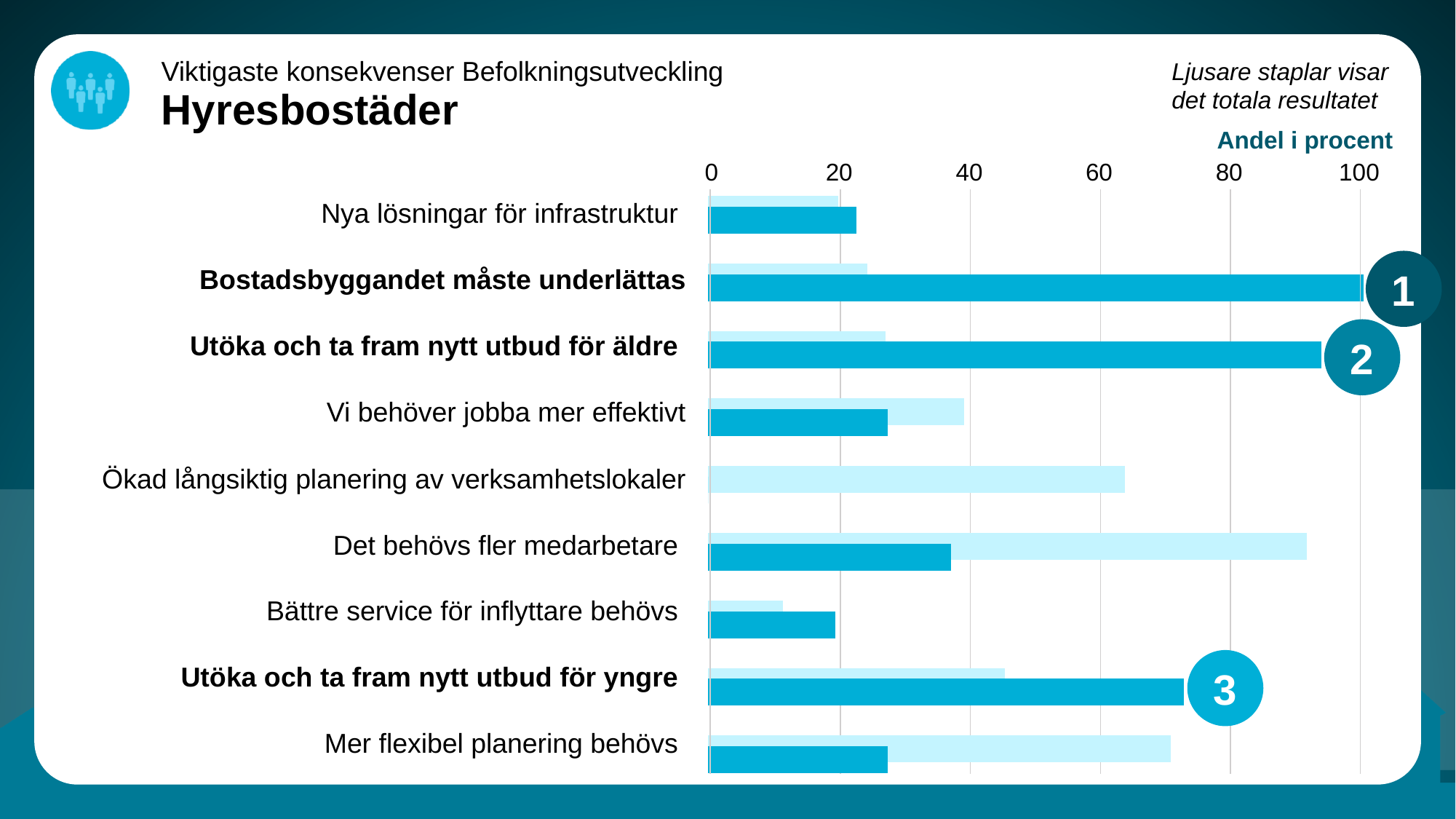
Is the darker bar for 'Utöka och ta fram nytt utbud för äldre' greater or less than 80? greater Which darker bar is longer: 'Utöka och ta fram nytt utbud för äldre' or 'Utöka och ta fram nytt utbud för yngre'? Utöka och ta fram nytt utbud för äldre According to the slide, what do the lighter bars show? det totala resultatet For 'Det behövs fler medarbetare', which bar is longer, the lighter or the darker one? the lighter one Which category has the shortest lighter bar? Bättre service för inflyttare behövs How many categories are listed on the chart? 9 Which category has the longest lighter bar? Det behövs fler medarbetare What kind of chart is shown on the slide? bar chart Which category has the longest darker bar? Bostadsbyggandet måste underlättas Is the lighter bar for 'Ökad långsiktig planering av verksamhetslokaler' greater or less than 60? greater Is the darker bar for 'Utöka och ta fram nytt utbud för yngre' greater or less than 60? greater